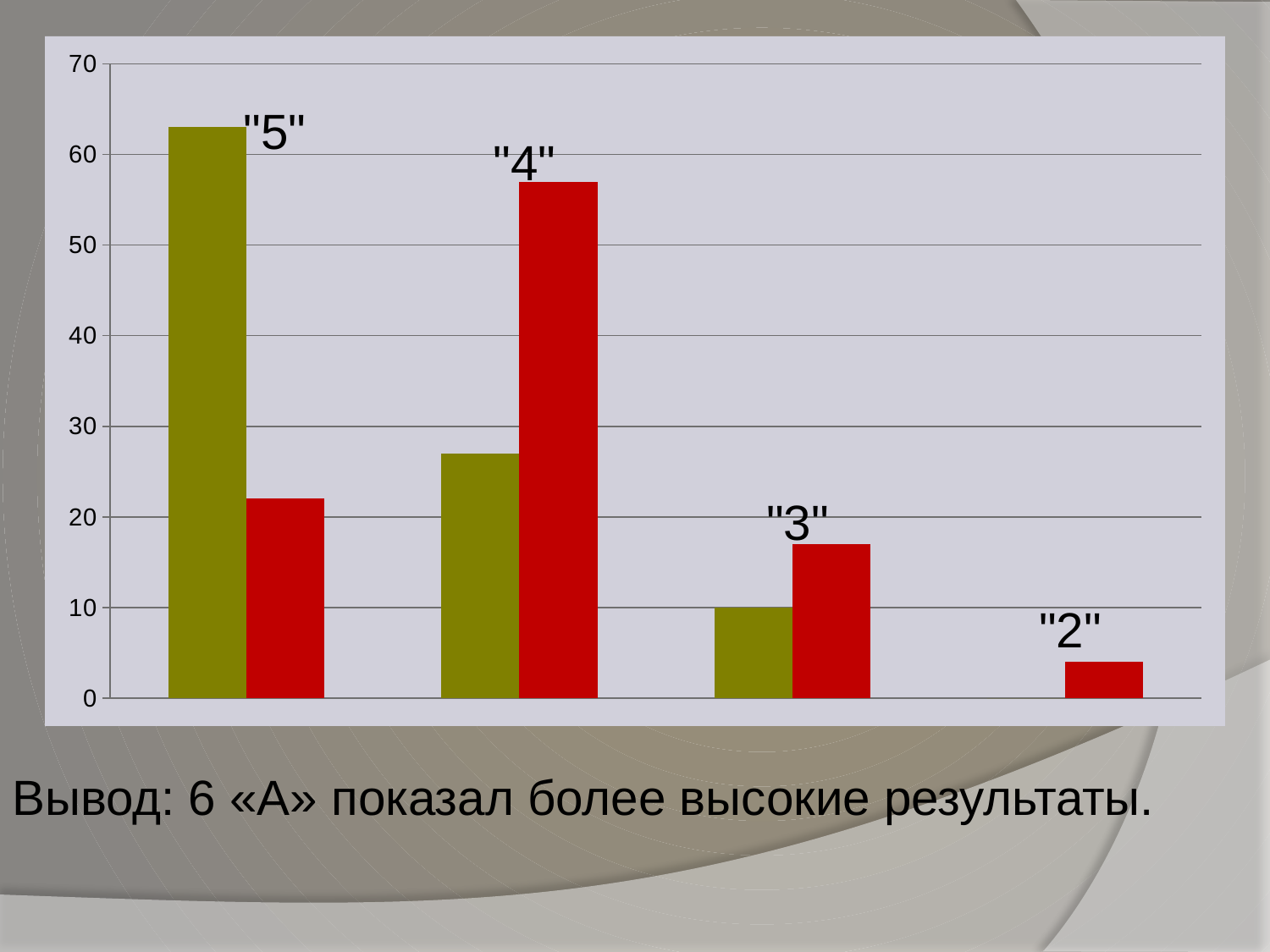
For category "4", which bar is taller, the green one or the red one? the red one Is the value of the green bar for category "4" greater or less than 30? less How many categories are labelled on the chart? 4 Is the value of the red bar for category "4" greater or less than 50? greater Is the value of the green bar for category "5" greater or less than 60? greater Do the green bars rise or fall from category "5" to category "3"? fall Which category has the shortest red bar? "2" Which category has the tallest red bar? "4" What kind of chart is shown on the slide? bar chart Which category has the tallest green bar? "5"